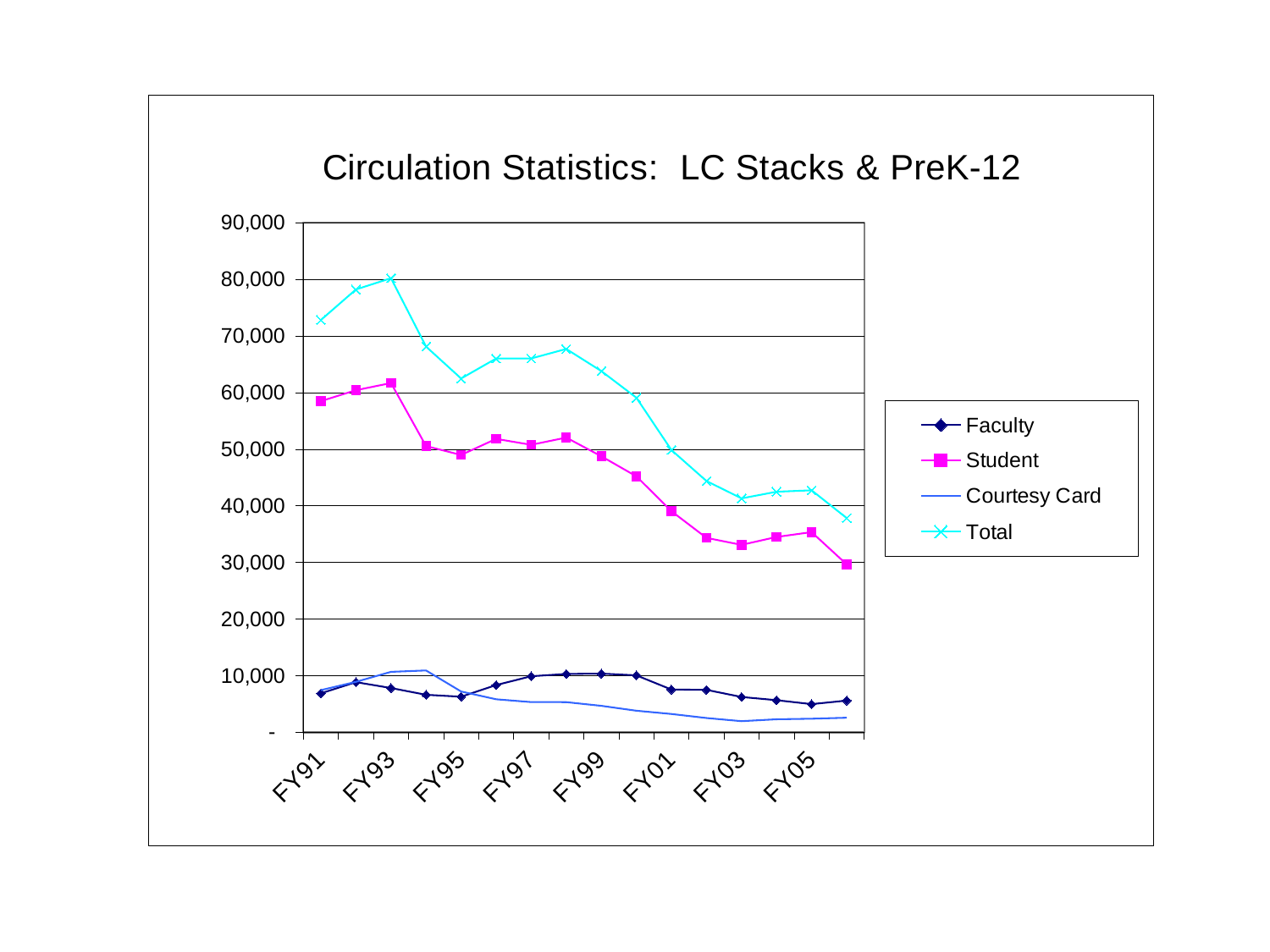
What is the title of the chart? Circulation Statistics: LC Stacks & PreK-12 At FY91, which is larger, the Student value or the Faculty value? Student Which series is drawn with x-shaped markers? Total Overall, does the Total series rise or fall from FY91 to FY06? Fall Is the Total value for FY93 greater or less than 70,000? greater Is the Total value for FY01 greater or less than 60,000? less Is the Student value for FY03 greater or less than 40,000? less In which fiscal year does the Total series reach its highest value? FY93 In which fiscal year is the Total series at its lowest value? FY06 What kind of chart is shown on the slide? Line chart How many fiscal year labels are shown on the x axis? 8 How many series does the legend list? 4